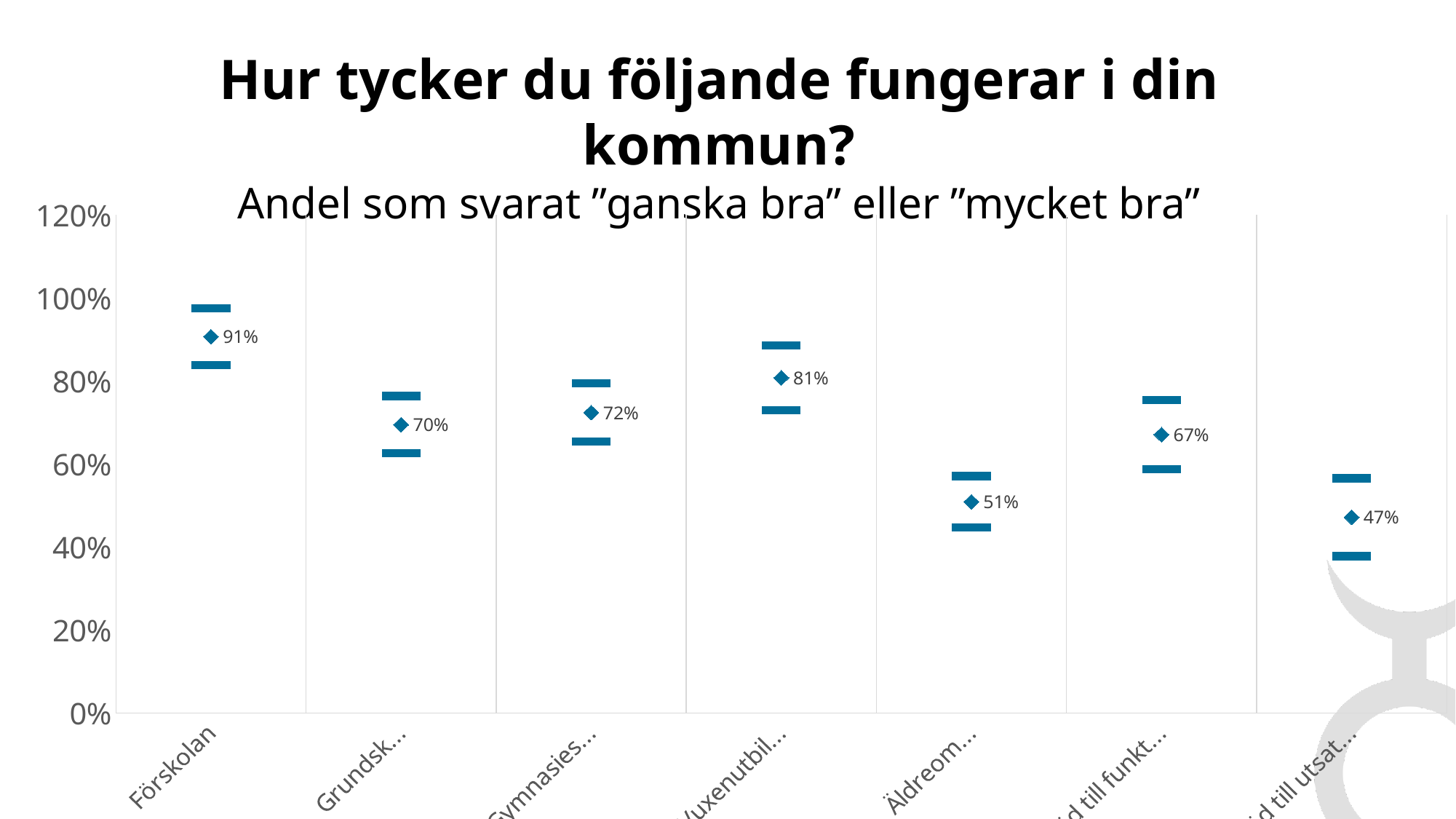
What is the value shown for the second category from the left (Grundsk...)? 70% What is the lowest value shown on the chart? 47% How many categories are plotted on the chart? 7 Which category has the highest value? Förskolan What is the value shown for the rightmost category? 47% What is the title of the slide? Hur tycker du följande fungerar i din kommun? Which is larger, the value for Förskolan or the value for the fourth category (Vuxenutbil...)? Förskolan What is the subtitle of the chart? Andel som svarat "ganska bra" eller "mycket bra" Is the value for the fifth category from the left (Äldreom...) greater or less than 60%? less What is the value shown for the fourth category from the left (Vuxenutbil...)? 81% What is the difference between the value for Förskolan and the value for the rightmost category? 44 percentage points What is the value shown for Förskolan? 91%